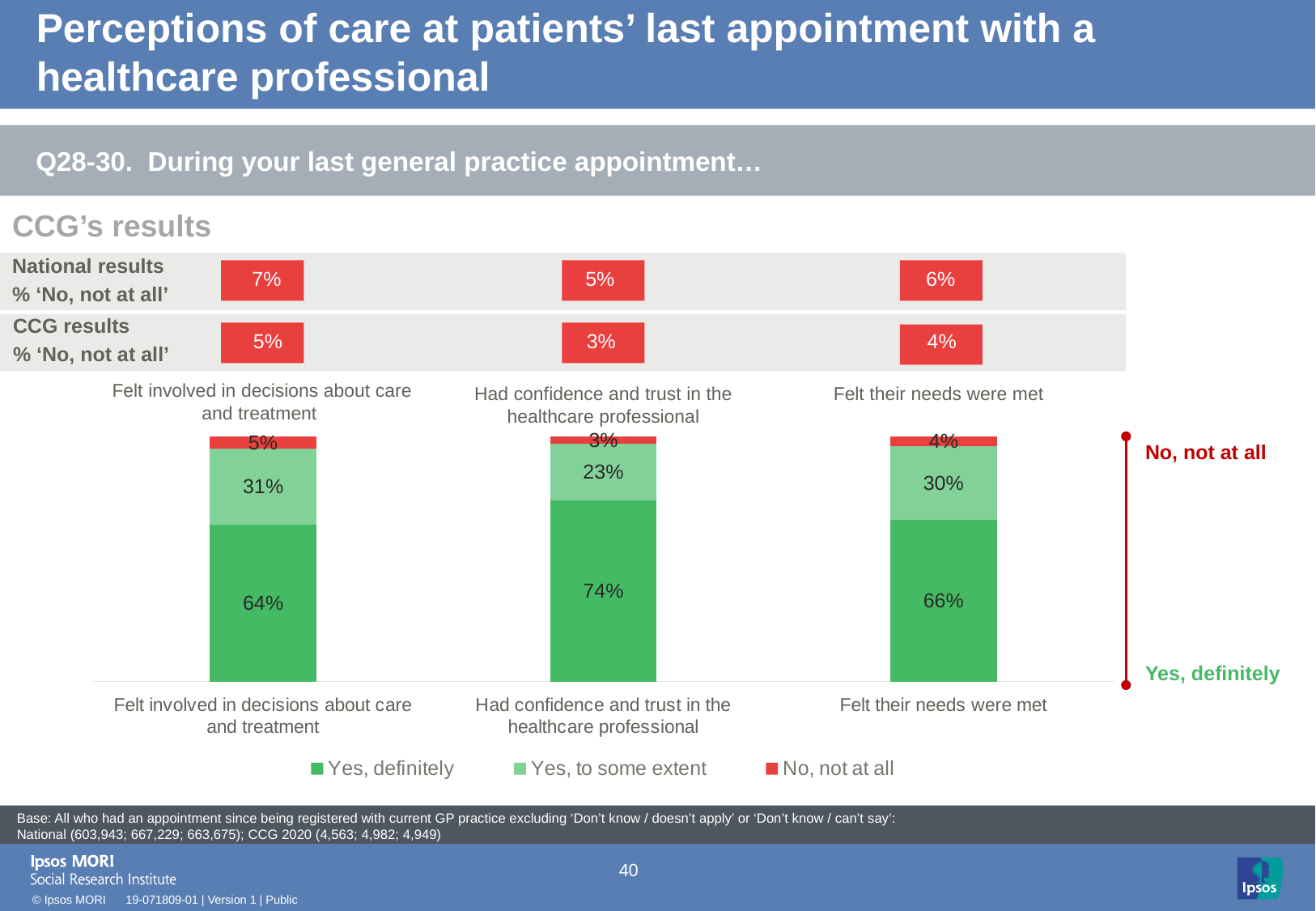
Which category has the highest 'Yes, definitely' percentage? Had confidence and trust in the healthcare professional What is the difference between the 'Yes, definitely' percentages for 'Had confidence and trust in the healthcare professional' and 'Felt their needs were met'? 8 percentage points Which colour represents 'No, not at all' in the chart legend? Red Which category has the lowest 'Yes, definitely' percentage? Felt involved in decisions about care and treatment What percentage of patients answered 'Yes, to some extent' for 'Felt involved in decisions about care and treatment'? 31% Is the 'Yes, to some extent' percentage larger for 'Felt involved in decisions about care and treatment' or for 'Had confidence and trust in the healthcare professional'? Felt involved in decisions about care and treatment How many series does the chart legend list? 3 How many categories are shown on the x axis of the chart? 3 What percentage of patients answered 'No, not at all' for 'Felt their needs were met'? 4% What kind of chart is shown on the slide? Stacked bar chart What percentage of patients answered 'Yes, definitely' for 'Had confidence and trust in the healthcare professional'? 74% What is the national 'No, not at all' percentage for 'Felt involved in decisions about care and treatment'? 7%